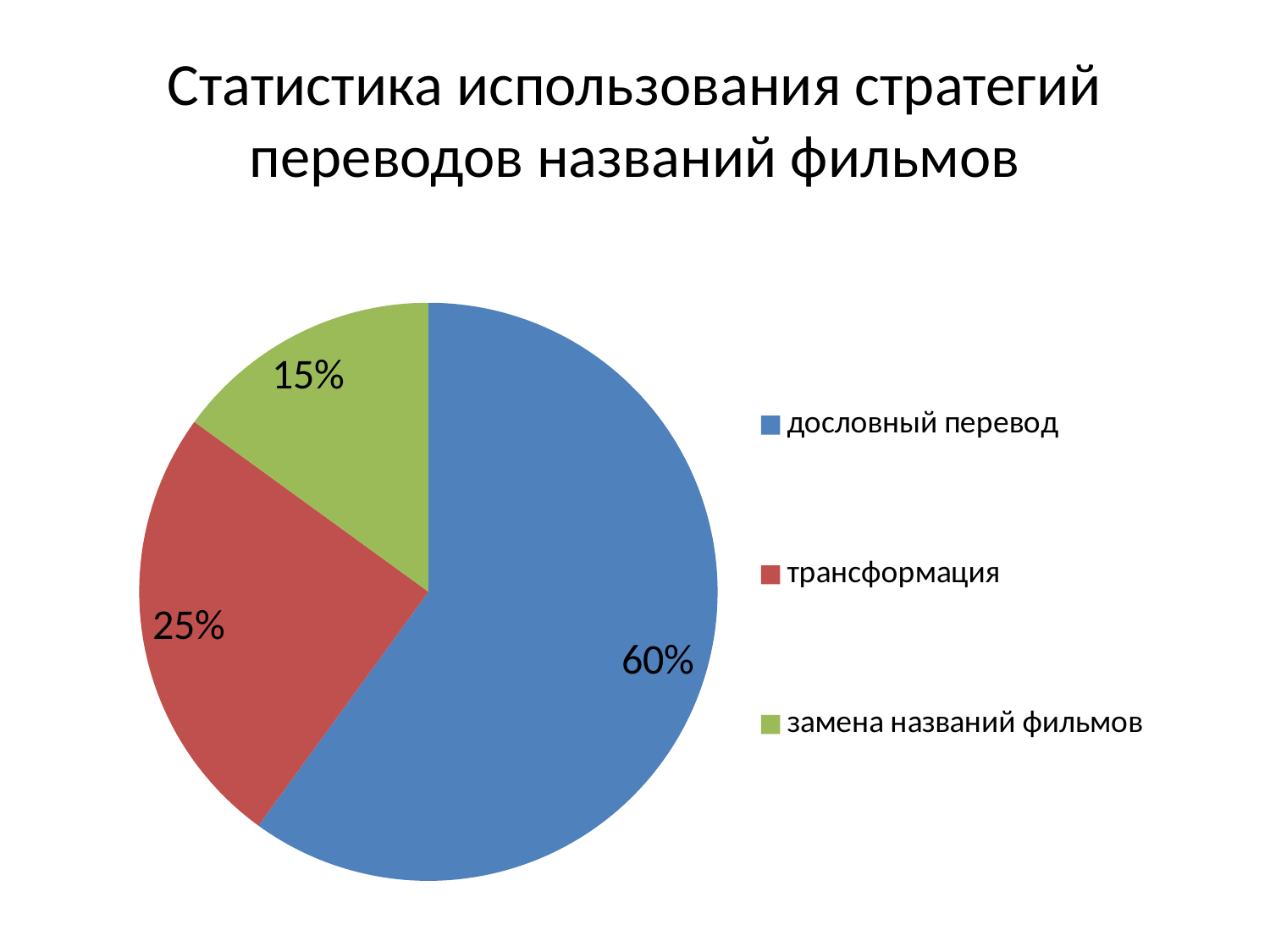
What is the difference in percentage points between "трансформация" and "замена названий фильмов"? 10% Which is larger, the slice for "трансформация" or the slice for "замена названий фильмов"? трансформация Which category has the smallest slice of the pie? замена названий фильмов What colour is the slice for "трансформация"? red What is the title of the chart on the slide? Статистика использования стратегий переводов названий фильмов What is the difference in percentage points between "дословный перевод" and "трансформация"? 35% What kind of chart is shown on the slide? pie chart What share of the pie does "дословный перевод" have? 60% How many categories does the pie chart show? 3 What share of the pie does "трансформация" have? 25% What share of the pie does "замена названий фильмов" have? 15% Which category has the largest slice of the pie? дословный перевод